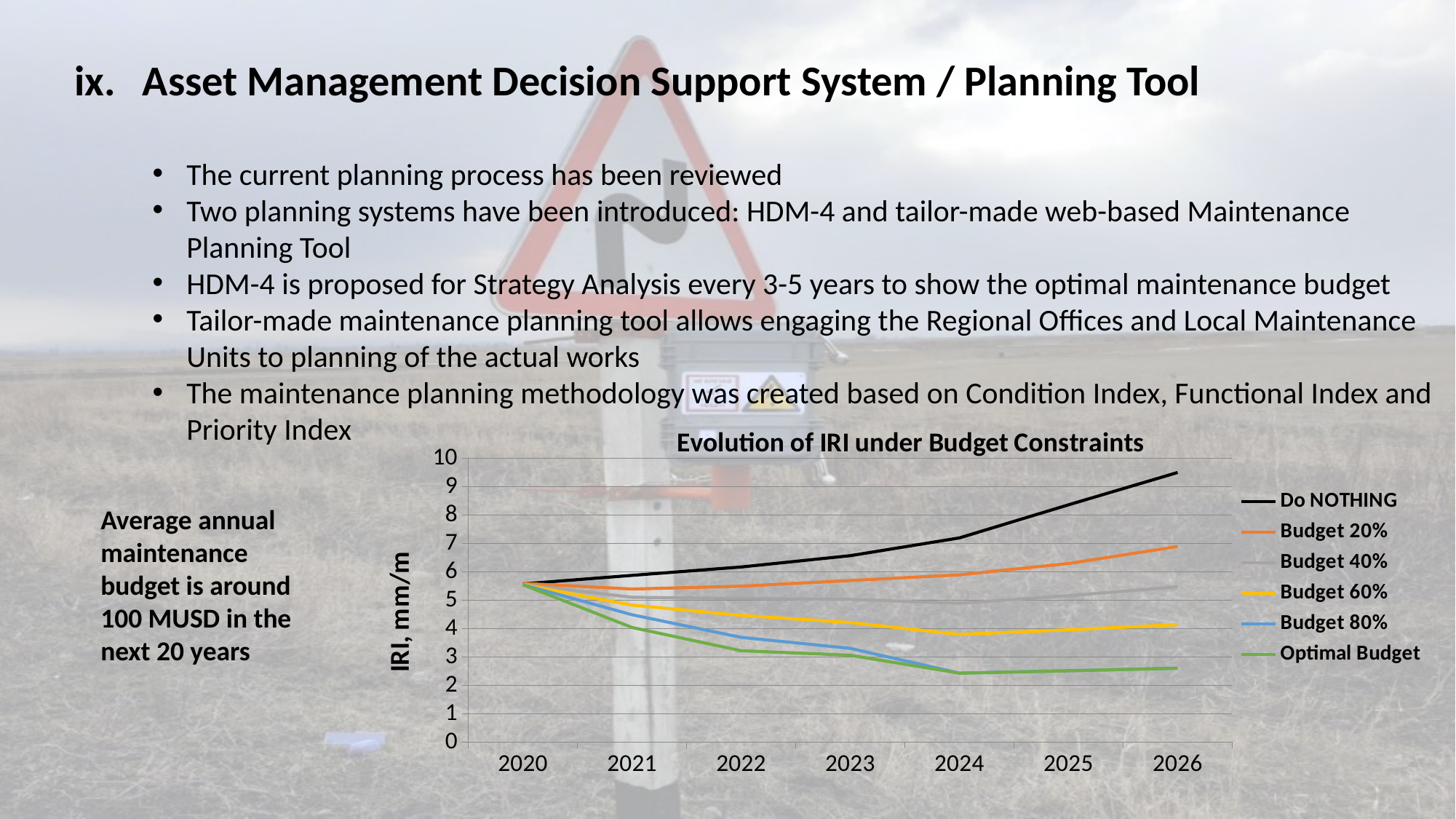
What is the label of the y axis of the chart? IRI, mm/m Is the value for Optimal Budget in 2024 greater or less than 3? less Which series has the highest value in 2026? Do NOTHING What kind of chart is shown on the slide? line chart Is the value for Do NOTHING in 2026 greater or less than 9? greater What is the title of the chart? Evolution of IRI under Budget Constraints In 2026, which is larger: the value for Budget 20% or the value for Budget 60%? Budget 20% Does the Do NOTHING series rise or fall from 2020 to 2026? rise How many years are shown on the x axis of the chart? 7 Is the value for Budget 80% in 2022 greater or less than 4? less How many series does the legend of the chart list? 6